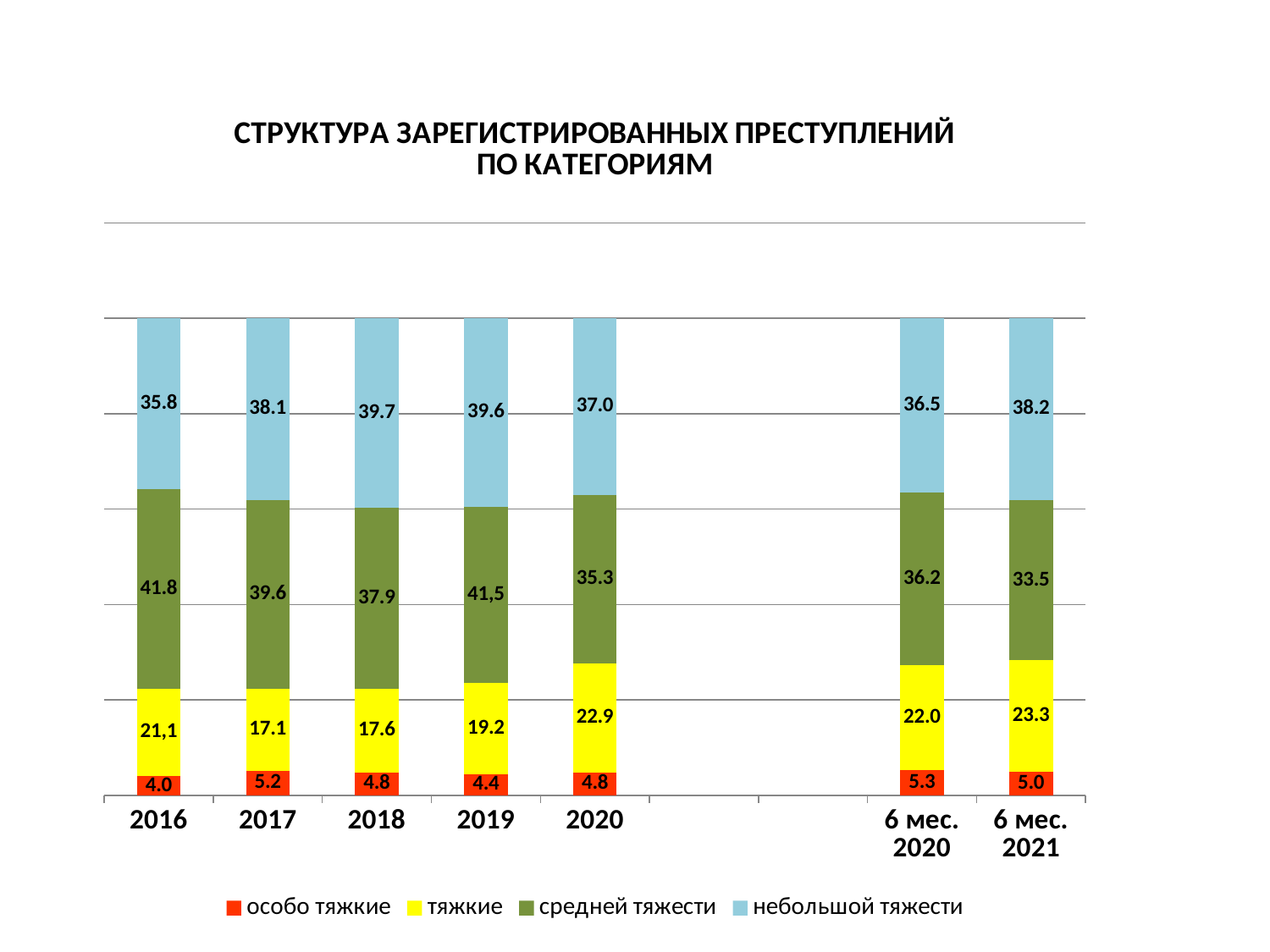
What is the value for средней тяжести in 6 мес. 2021? 33.5 What is the value for небольшой тяжести in 2018? 39.7 What is the value for особо тяжкие in 2017? 5.2 What is the total of the stacked bar for 2020? 100.0 How many periods are shown on the x axis? 7 In which period is the особо тяжкие segment the smallest? 2016 In which period is the тяжкие segment the largest? 6 мес. 2021 What is the difference between the небольшой тяжести values for 2017 and 2016? 2.3 How many series does the legend list? 4 What is the value for тяжкие in 2019? 19.2 What kind of chart is shown on the slide? Stacked bar chart